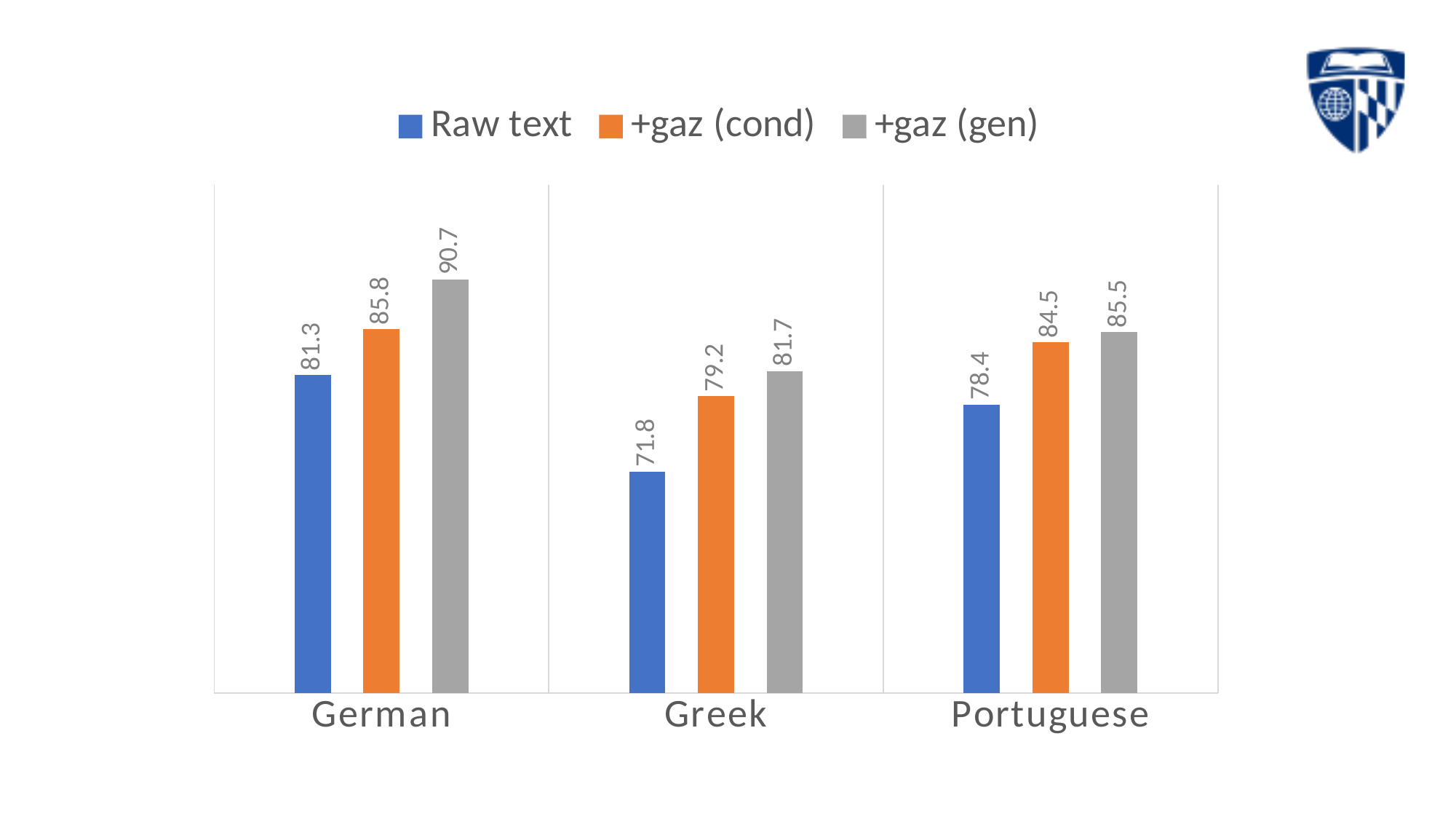
What is the Raw text value for German? 81.3 What kind of chart is shown on the slide? Bar chart Which is larger: the Raw text value for German or the Raw text value for Portuguese? German What is the +gaz (gen) value for Greek? 81.7 Which colour represents the +gaz (cond) series in the legend? Orange What is the +gaz (cond) value for Portuguese? 84.5 Which language has the lowest Raw text value? Greek How many series does the legend list? 3 What is the difference between the +gaz (cond) and Raw text values for Greek? 7.4 Which language has the highest +gaz (gen) value? German How many languages are shown on the x axis? 3 What is the difference between the +gaz (gen) and Raw text values for German? 9.4